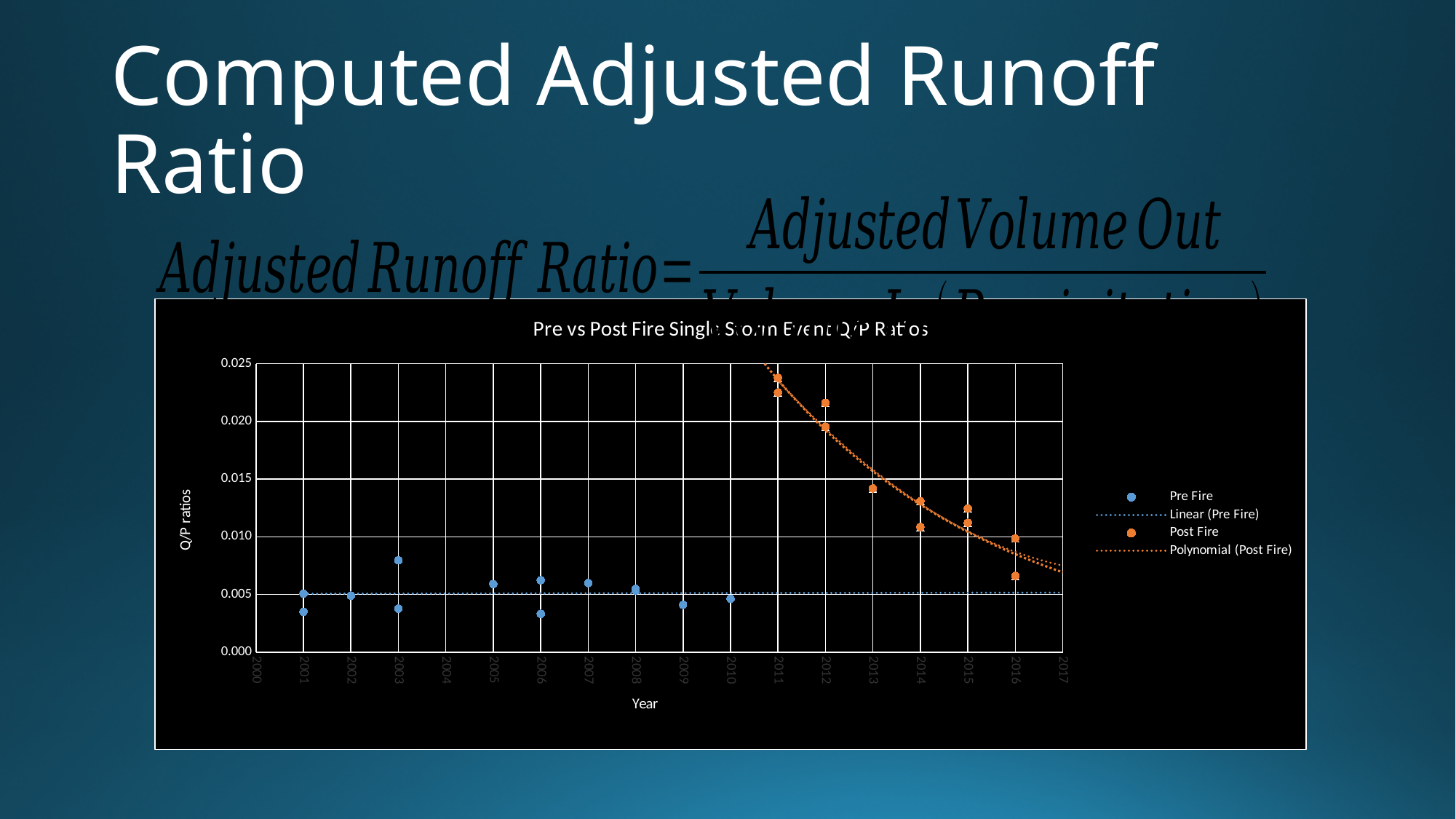
In which year is the highest Q/P ratio on the chart plotted? 2011 Do the Post Fire values rise or fall from 2011 to 2016? fall Is the lowest Post Fire value plotted for 2016 greater or less than 0.010? less What is the label of the vertical axis of the chart? Q/P ratios How many entries does the chart legend list? 4 Is the Post Fire value plotted for 2013 greater or less than 0.010? greater What kind of chart is shown on the slide? Scatter chart In how many different years are Post Fire points plotted? 6 What is the title of the chart? Pre vs Post Fire Single Storm Event Q/P Ratios Is the highest Post Fire value plotted for 2011 greater or less than 0.020? greater Which series has the higher Q/P ratio values, Pre Fire or Post Fire? Post Fire